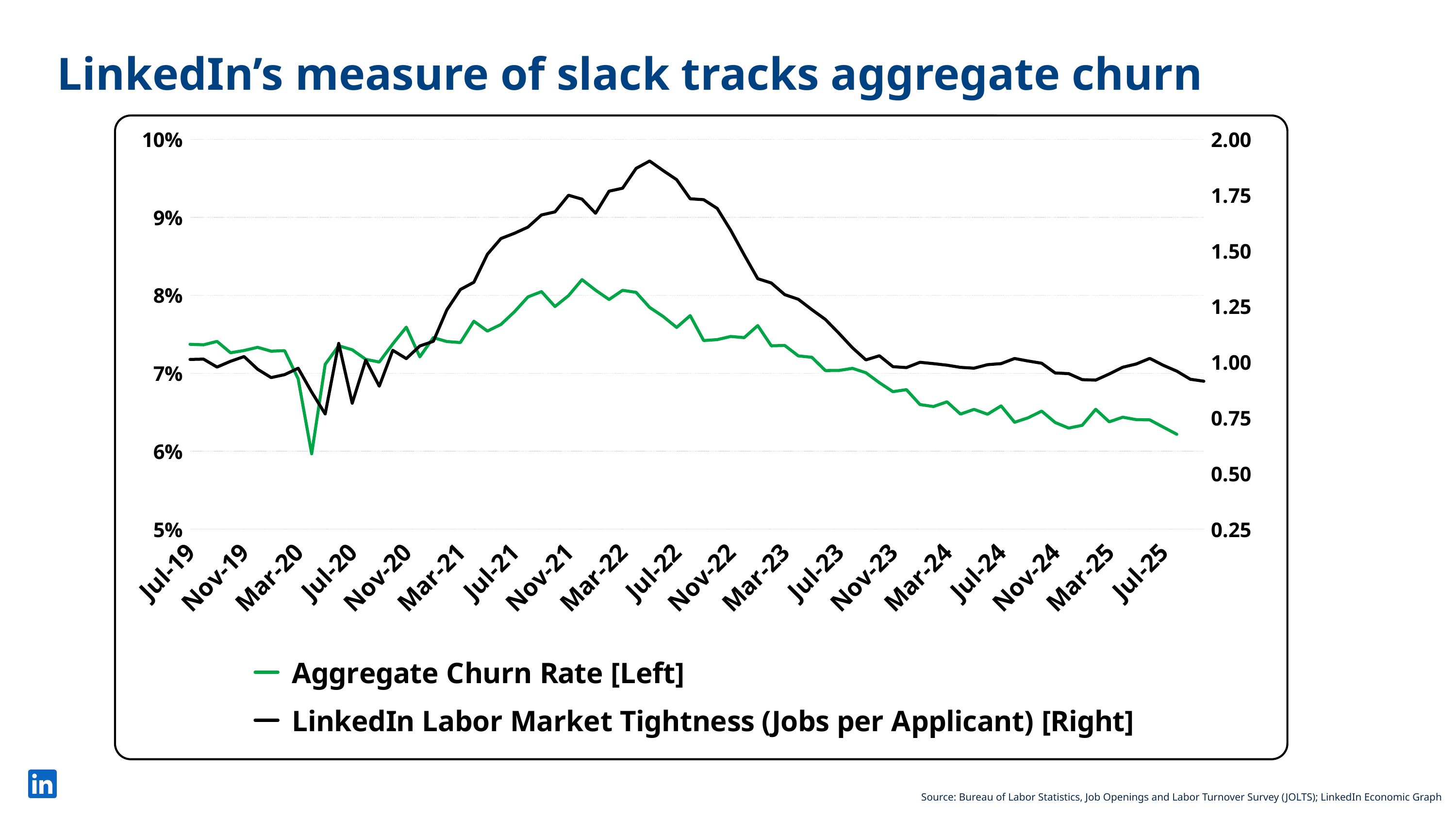
Is the Aggregate Churn Rate at Jul-25 greater or less than 7%? less Is the LinkedIn Labor Market Tightness value at Jul-25 greater or less than 1.25? less How many series does the legend list? 2 Is the Aggregate Churn Rate at Jul-22 greater or less than 7%? greater Does the Aggregate Churn Rate rise or fall between Jul-22 and Jul-25? Fall What kind of chart is shown on the slide? Line chart Which series is plotted against the right-hand axis? LinkedIn Labor Market Tightness (Jobs per Applicant) What colour is the Aggregate Churn Rate line? Green Is the Aggregate Churn Rate higher at Jul-19 or at Jul-25? Jul-19